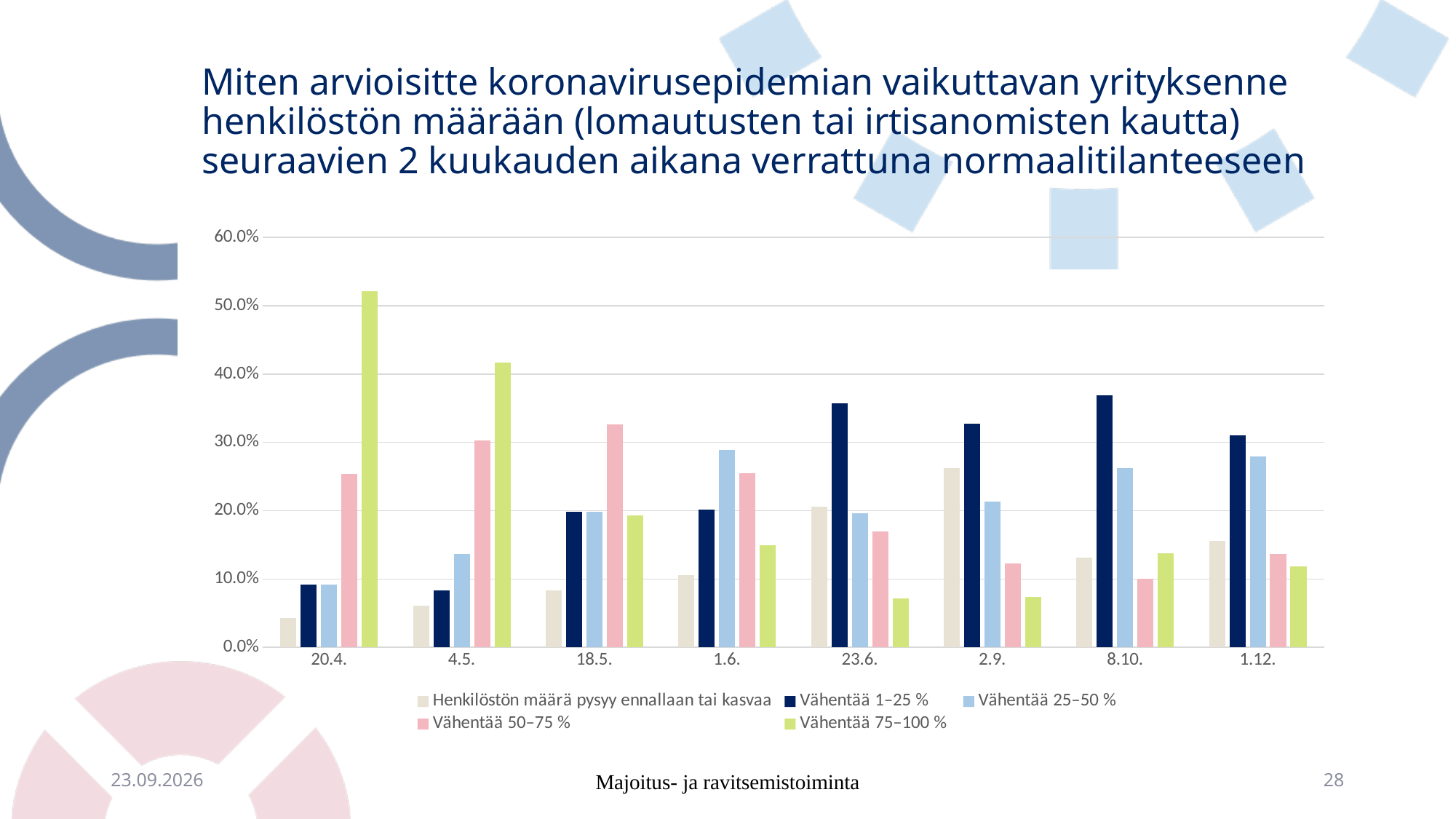
Which colour represents Vähentää 75–100 % in the legend? green At 1.6., which is larger: Vähentää 1–25 % or Vähentää 25–50 %? Vähentää 25–50 % At which date is the value for Vähentää 75–100 % highest? 20.4. Is the value for Vähentää 1–25 % at 8.10. greater or less than 30.0%? greater Is the value for Vähentää 75–100 % at 4.5. greater or less than 40.0%? greater At which date is the value for Henkilöstön määrä pysyy ennallaan tai kasvaa highest? 2.9. What kind of chart is shown on the slide? bar chart Does the value for Vähentää 75–100 % rise or fall from 20.4. to 23.6.? fall Is the value for Henkilöstön määrä pysyy ennallaan tai kasvaa at 20.4. greater or less than 10.0%? less How many survey dates (categories) are shown on the x axis? 8 How many series does the legend list? 5